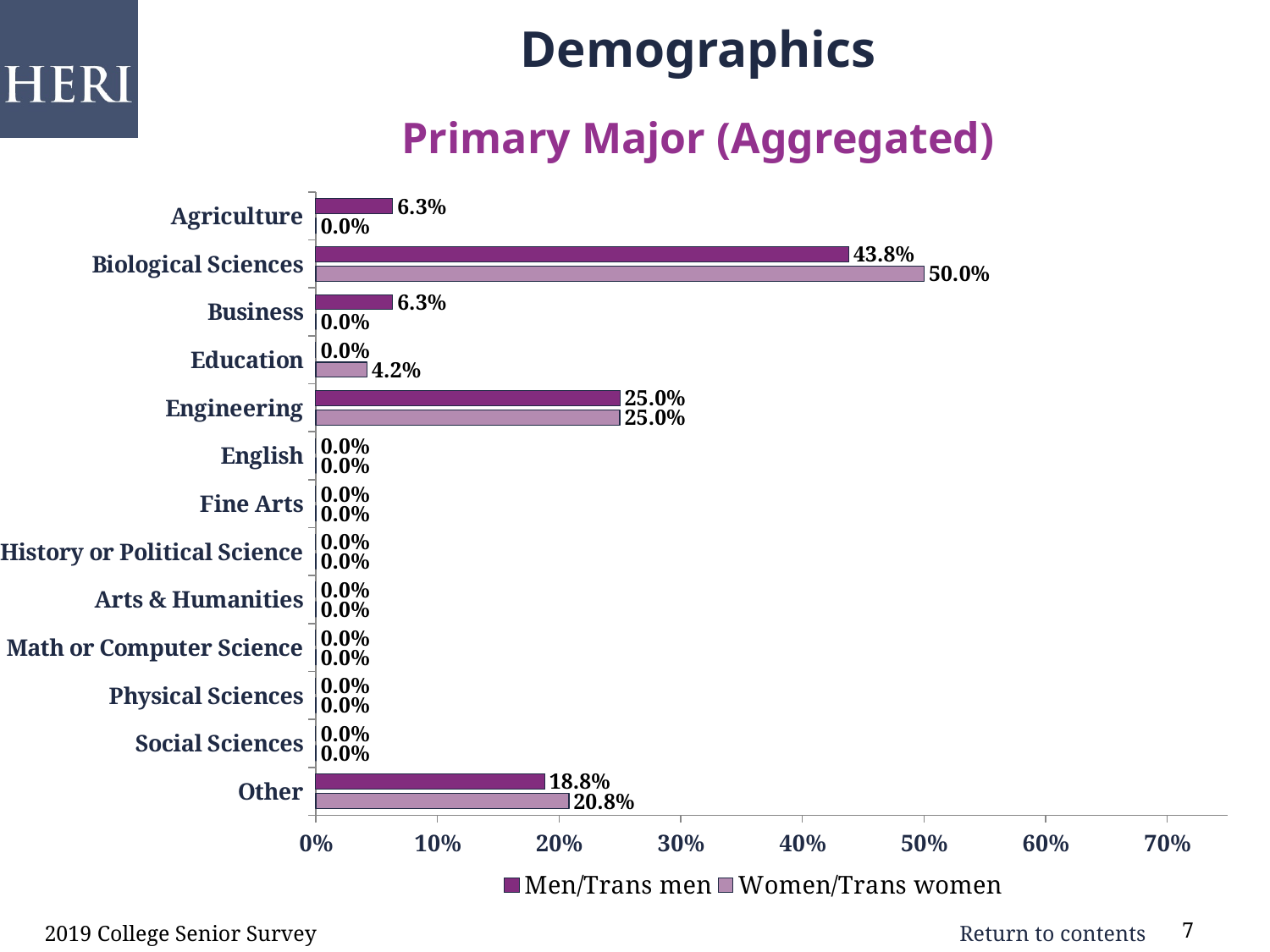
How many series does the legend list? 2 Which category has the highest value for Women/Trans women? Biological Sciences What kind of chart is shown on the slide? Bar chart Is the Men/Trans men value for Engineering greater or less than 20%? greater Which is larger for Other: the Men/Trans men value or the Women/Trans women value? Women/Trans women What is the value for Women/Trans women in Education? 4.2% What is the value for Women/Trans women in Other? 20.8% What is the difference between the Women/Trans women and Men/Trans men values for Biological Sciences? 6.2% How many categories are shown on the chart? 13 What is the title of the chart? Primary Major (Aggregated) Which category has the highest value for Men/Trans men? Biological Sciences What is the value for Men/Trans men in Biological Sciences? 43.8%